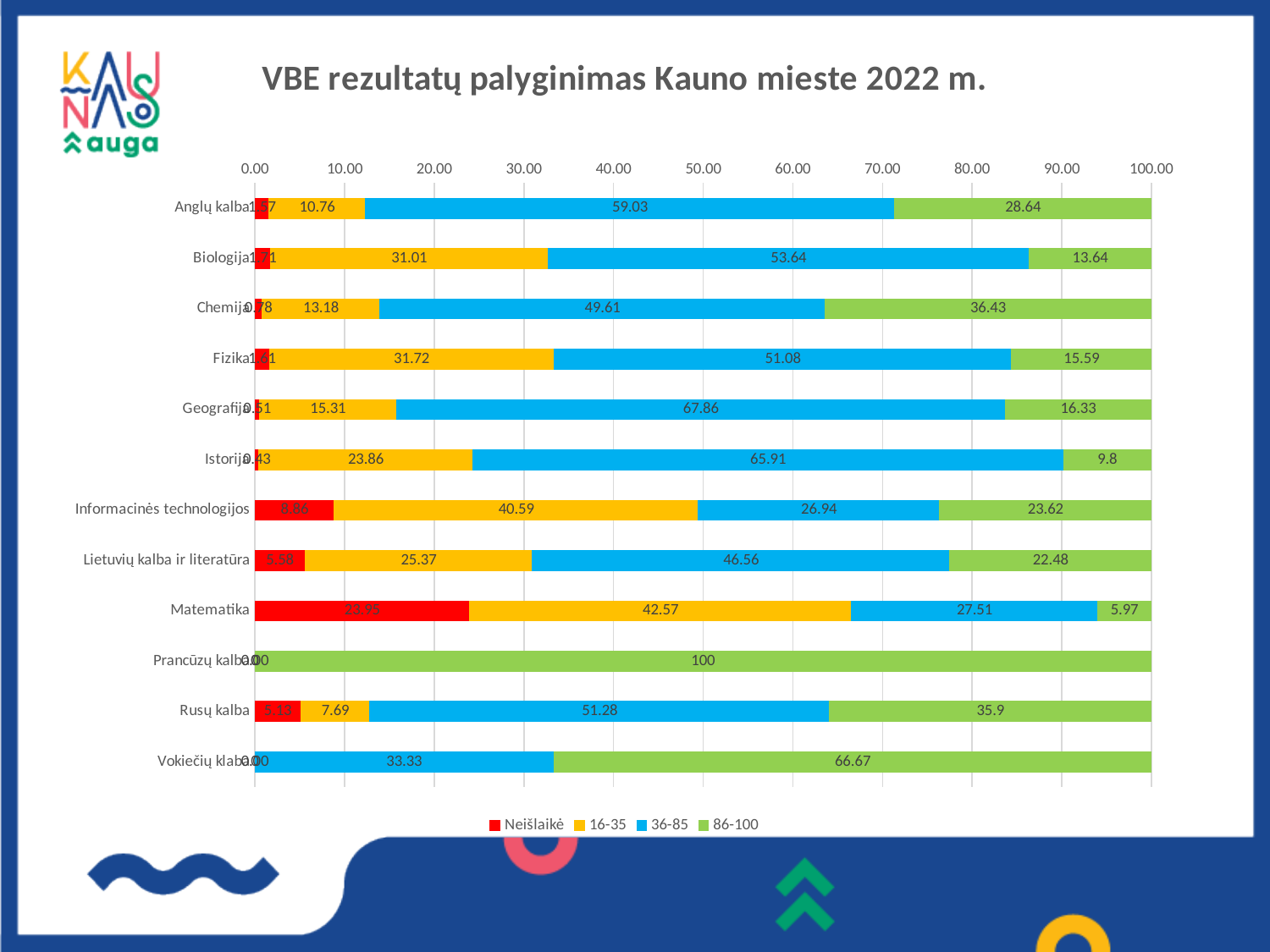
Which subject has the highest value in the 86-100 series? Prancūzų kalba Which is larger: the 86-100 value for Rusų kalba or the 86-100 value for Anglų kalba? Rusų kalba What is the value of the 16-35 series for Informacinės technologijos? 40.59 What is the title of the chart? VBE rezultatų palyginimas Kauno mieste 2022 m. What is the value of the 36-85 series for Anglų kalba? 59.03 What is the value of the Neišlaikė series for Matematika? 23.95 How many subjects (categories) are plotted on the chart? 12 What is the value of the 86-100 series for Chemija? 36.43 What is the difference between the 36-85 values for Geografija and Istorija? 1.95 Which subject has the highest value in the Neišlaikė series? Matematika What kind of chart is shown on the slide? stacked bar chart How many series does the legend list? 4